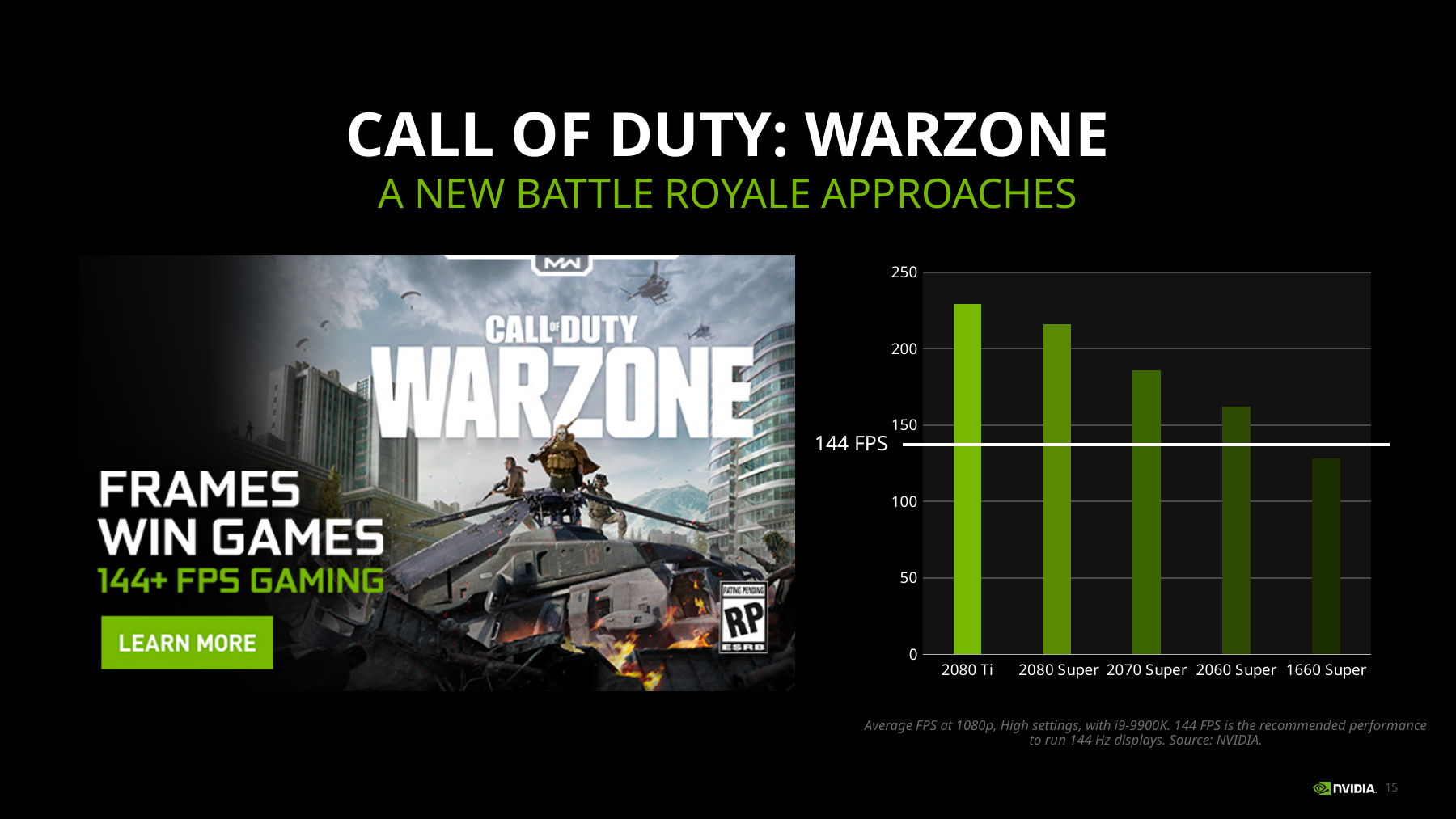
Which GPU has the highest average FPS on the chart? 2080 Ti Is the value for 2080 Ti greater or less than 200? greater Is the value for 1660 Super greater or less than 100? greater Is the value for 2070 Super greater or less than 150? greater What value is labelled on the horizontal reference line drawn across the chart? 144 FPS Which has a higher value, 2080 Super or 2060 Super? 2080 Super Which GPU has the lowest average FPS on the chart? 1660 Super How many GPU categories are plotted on the chart? 5 What kind of chart is shown on the right side of the slide? bar chart Do the bar values rise or fall moving from left to right along the x axis? fall